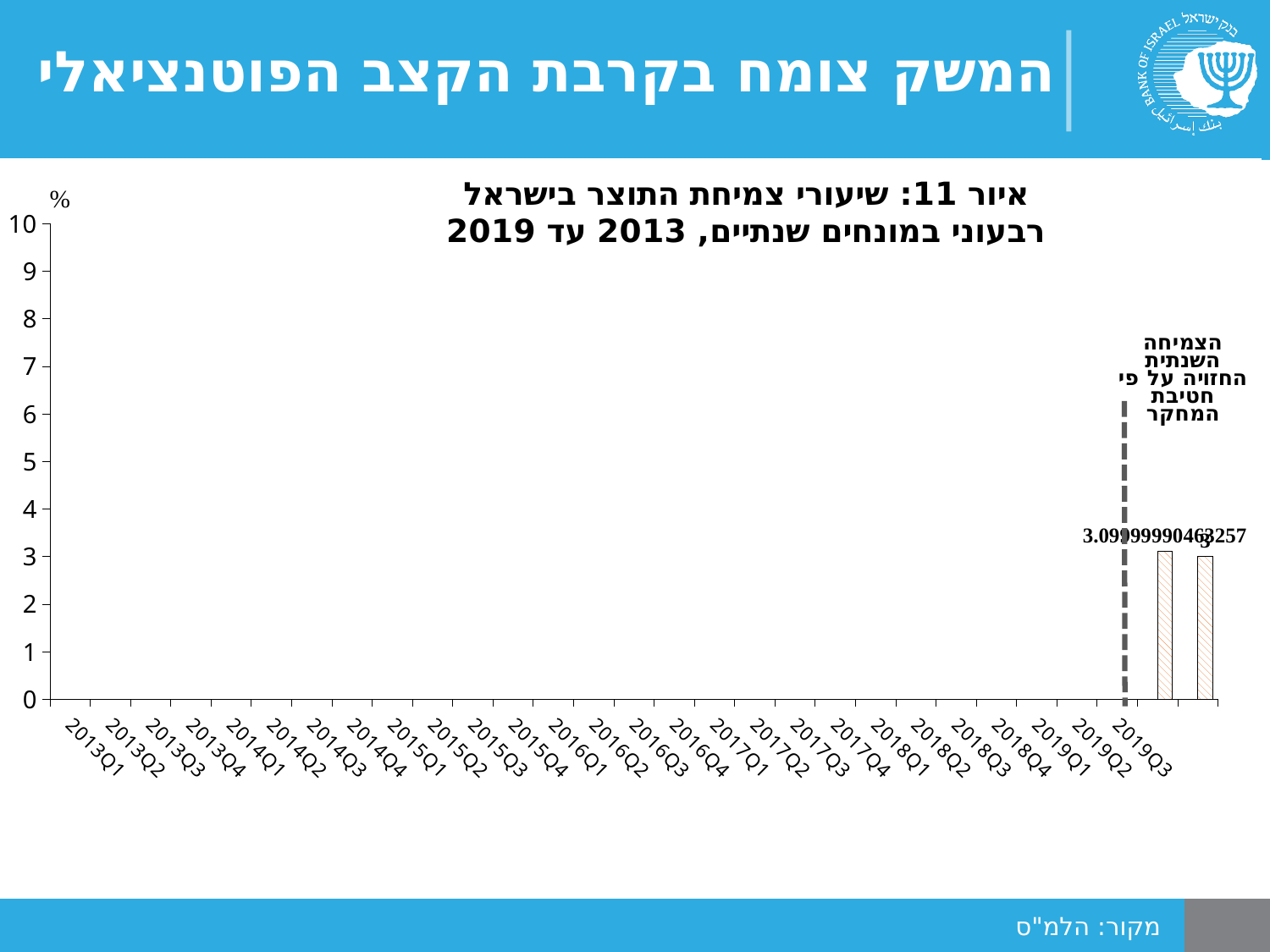
What kind of chart is shown on the slide? bar chart What is the last category on the x axis? 2019Q3 What is the highest tick value shown on the y axis? 10 What is the first category on the x axis? 2013Q1 What unit is shown at the top of the y axis? % How many quarterly categories are listed along the x axis? 27